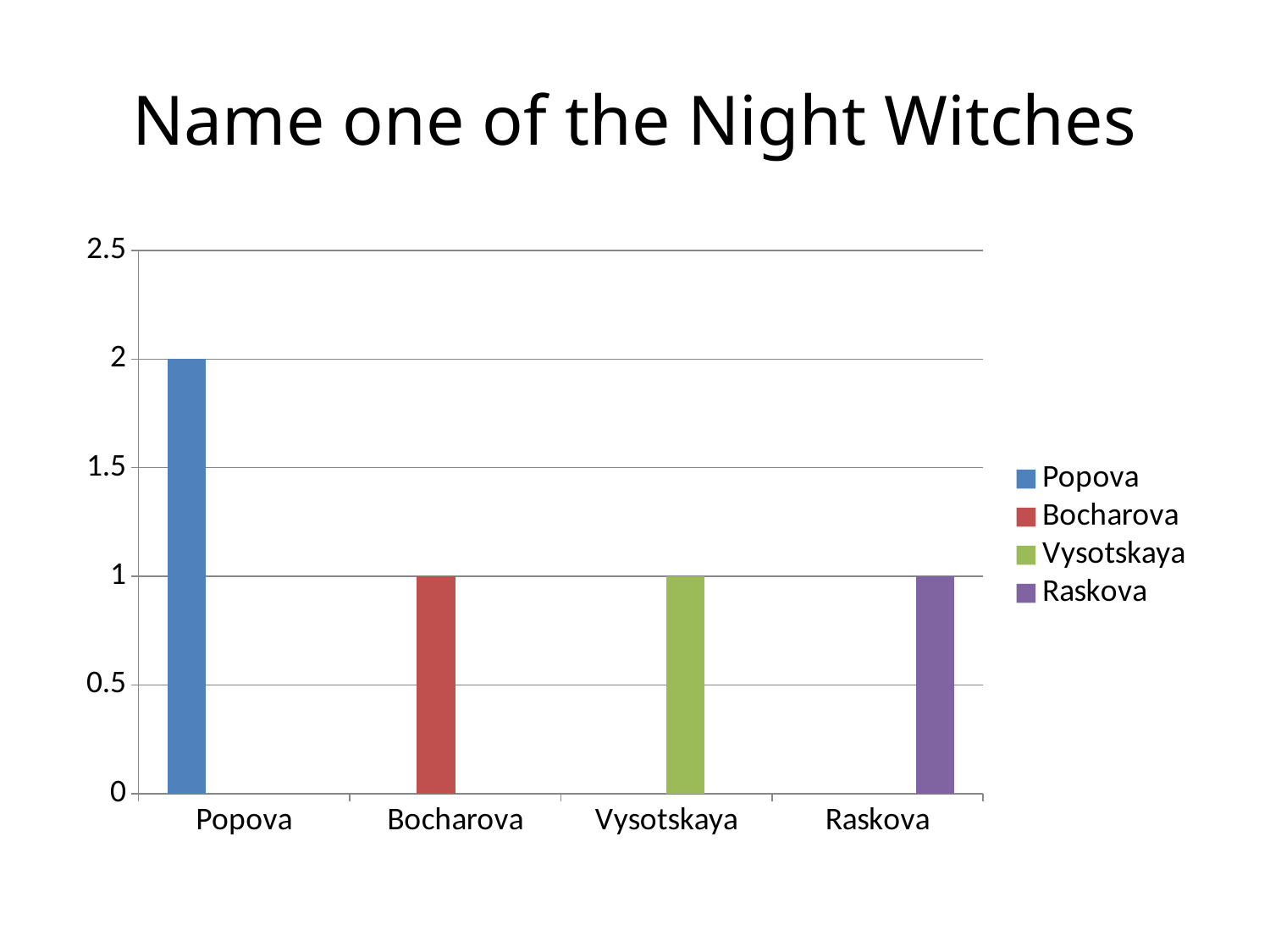
How many categories are shown on the x axis? 4 Which is larger, the value for Popova or the value for Bocharova? Popova Is the value for Raskova greater or less than 1.5? less What is the value for Bocharova? 1 What is the difference between the values for Popova and Vysotskaya? 1 Is the value for Popova greater or less than 1.5? greater What kind of chart is shown on the slide? bar chart How many entries does the legend list? 4 Which category has the highest value? Popova What is the value for Popova? 2 What is the value for Raskova? 1 What is the title of the slide? Name one of the Night Witches